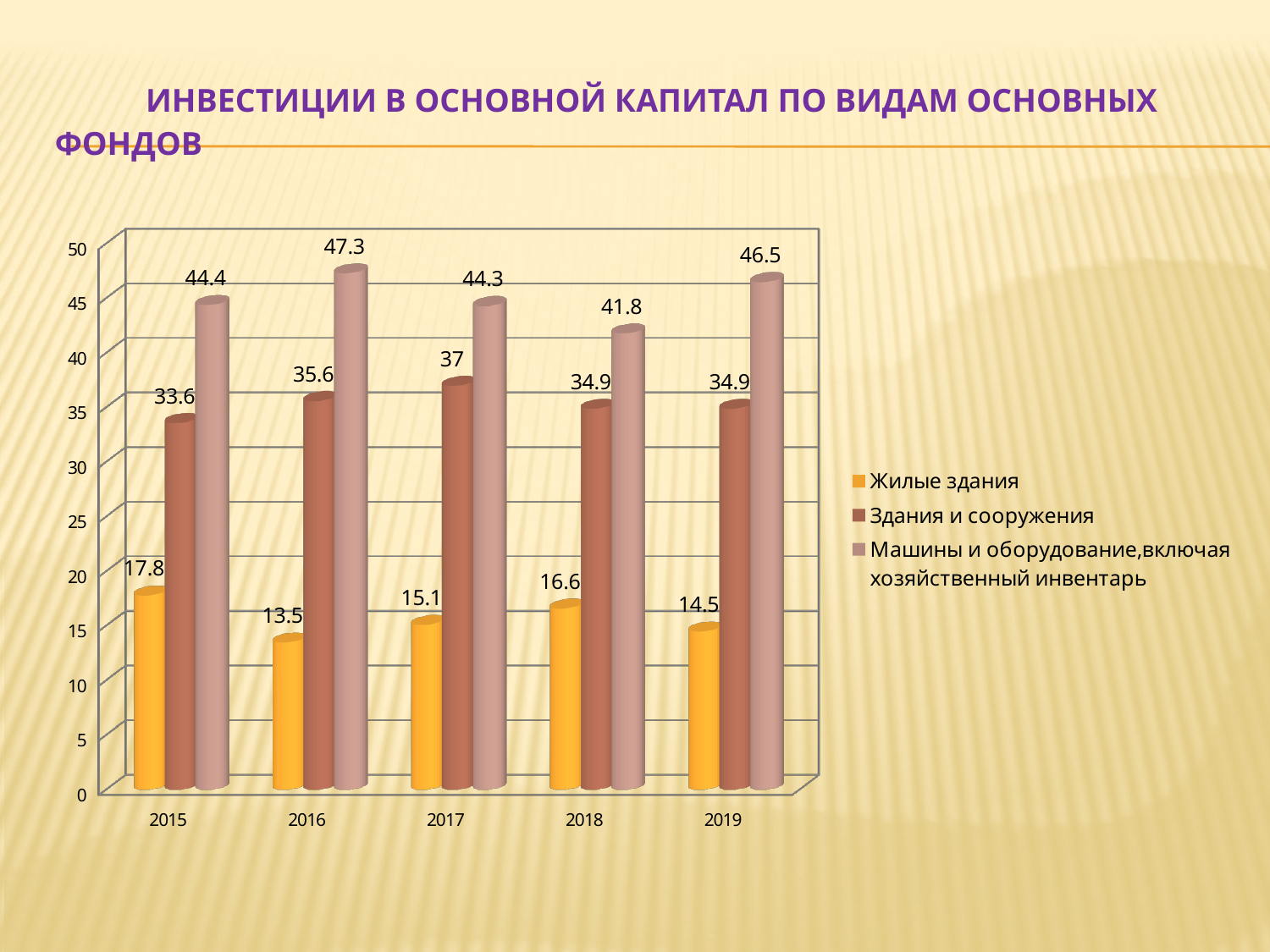
How many years are shown on the x axis? 5 How many series does the legend list? 3 In which year is the value for Жилые здания the lowest? 2016 What is the value for Машины и оборудование, включая хозяйственный инвентарь in 2019? 46.5 Is the value for Здания и сооружения in 2015 greater or less than 30? greater What kind of chart is shown on the slide? bar chart What colour are the bars for Жилые здания? yellow What is the value for Здания и сооружения in 2017? 37 What is the difference between the Машины и оборудование value and the Здания и сооружения value in 2018? 6.9 In which year is the value for Машины и оборудование, включая хозяйственный инвентарь the highest? 2016 Which is larger: the Здания и сооружения value in 2016 or in 2017? 2017 What is the value for Жилые здания in 2015? 17.8